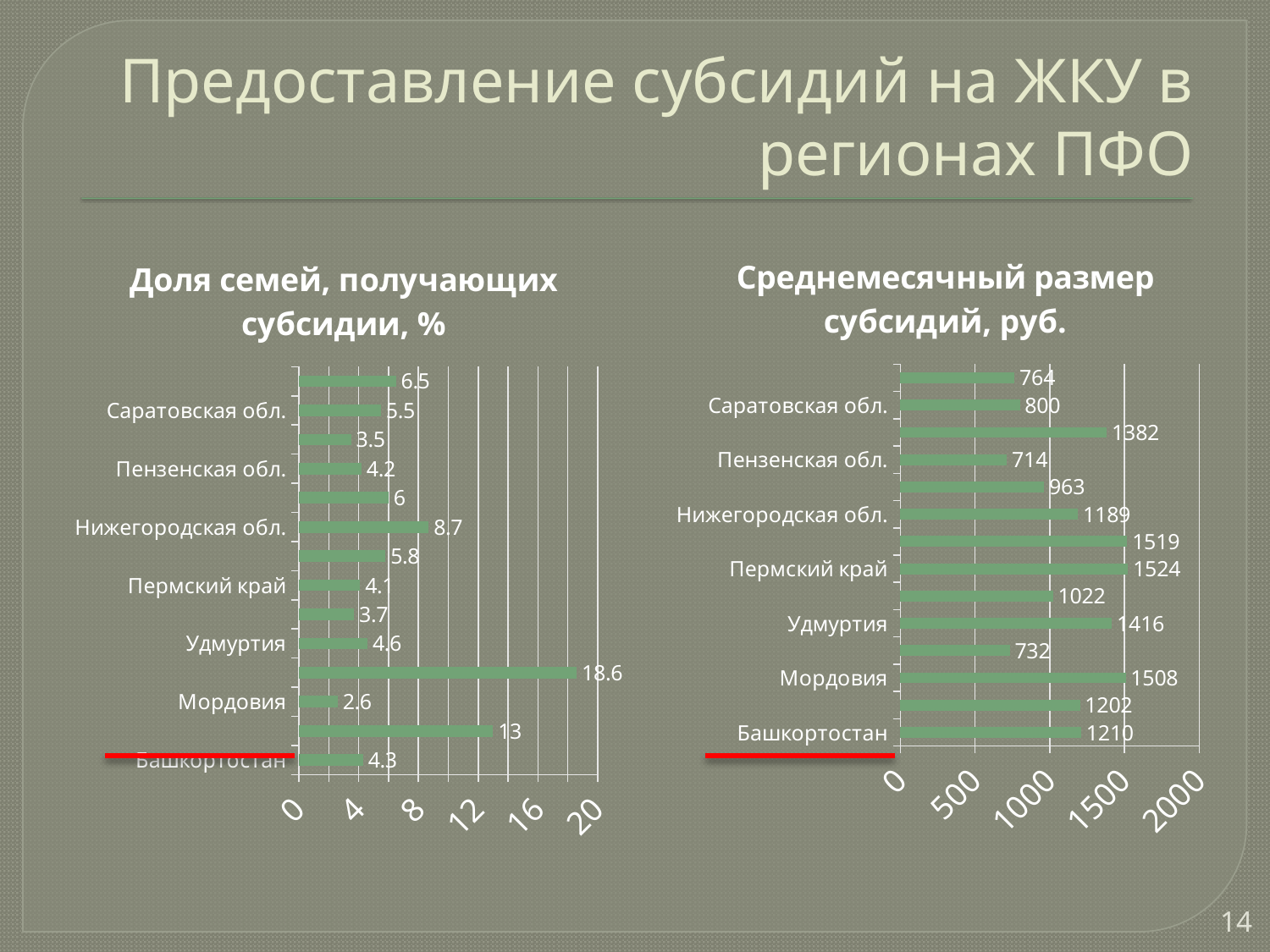
In the right chart 'Среднемесячный размер субсидий, руб.', what is the value for Пензенская обл.? 714 In the left chart 'Доля семей, получающих субсидии, %', which labeled region has the lowest value? Мордовия What type of chart is the left chart 'Доля семей, получающих субсидии, %'? Bar chart In the right chart 'Среднемесячный размер субсидий, руб.', what is the value for Пермский край? 1524 What is the title of the right chart on the slide? Среднемесячный размер субсидий, руб. In the right chart 'Среднемесячный размер субсидий, руб.', which is larger: Удмуртия or Саратовская обл.? Удмуртия In the left chart 'Доля семей, получающих субсидии, %', what is the value for Нижегородская обл.? 8.7 In the left chart 'Доля семей, получающих субсидии, %', which is larger: Башкортостан or Удмуртия? Удмуртия In the left chart 'Доля семей, получающих субсидии, %', what is the difference between Саратовская обл. and Пензенская обл.? 1.3 In the right chart 'Среднемесячный размер субсидий, руб.', what is the difference between Мордовия and Башкортостан? 298 How many bars are plotted in the right chart 'Среднемесячный размер субсидий, руб.'? 14 In the left chart 'Доля семей, получающих субсидии, %', what is the value for Мордовия? 2.6